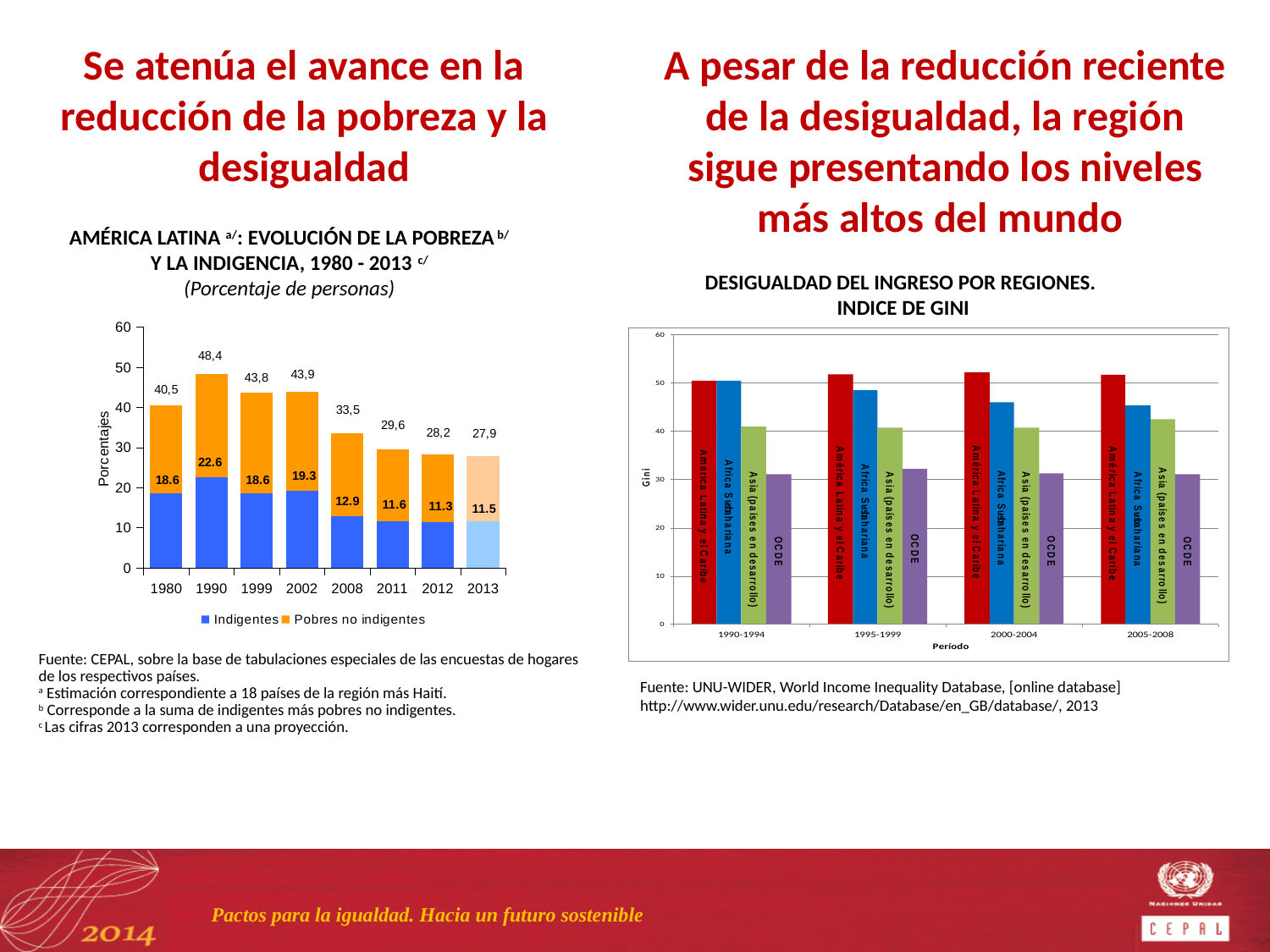
How many years are shown on the x axis of the left chart on poverty and indigence? 8 How many series does the legend of the left chart on poverty and indigence list? 2 What kind of chart is the left chart, 'AMÉRICA LATINA: EVOLUCIÓN DE LA POBREZA Y LA INDIGENCIA, 1980 - 2013'? Bar chart (stacked) In the left chart on poverty and indigence, what is the total percentage shown for 1990? 48,4 In the left chart on poverty and indigence, which year has the highest total percentage? 1990 How many periods are shown on the x axis of the right chart, 'DESIGUALDAD DEL INGRESO POR REGIONES. INDICE DE GINI'? 4 In the left chart on poverty and indigence, what is the difference between the Indigentes value in 1990 and in 1980? 4.0 In the left chart on poverty and indigence, what is the value for Indigentes in 2008? 12.9 In the right chart on the Gini index, is the value for OCDE in 1990-1994 greater or less than 40? less In the left chart on poverty and indigence, which year has the lowest total percentage? 2013 In the left chart on poverty and indigence, do the total percentages rise or fall from 2002 to 2013? Fall In the right chart on the Gini index, which region has the highest value in 2000-2004? América Latina y el Caribe